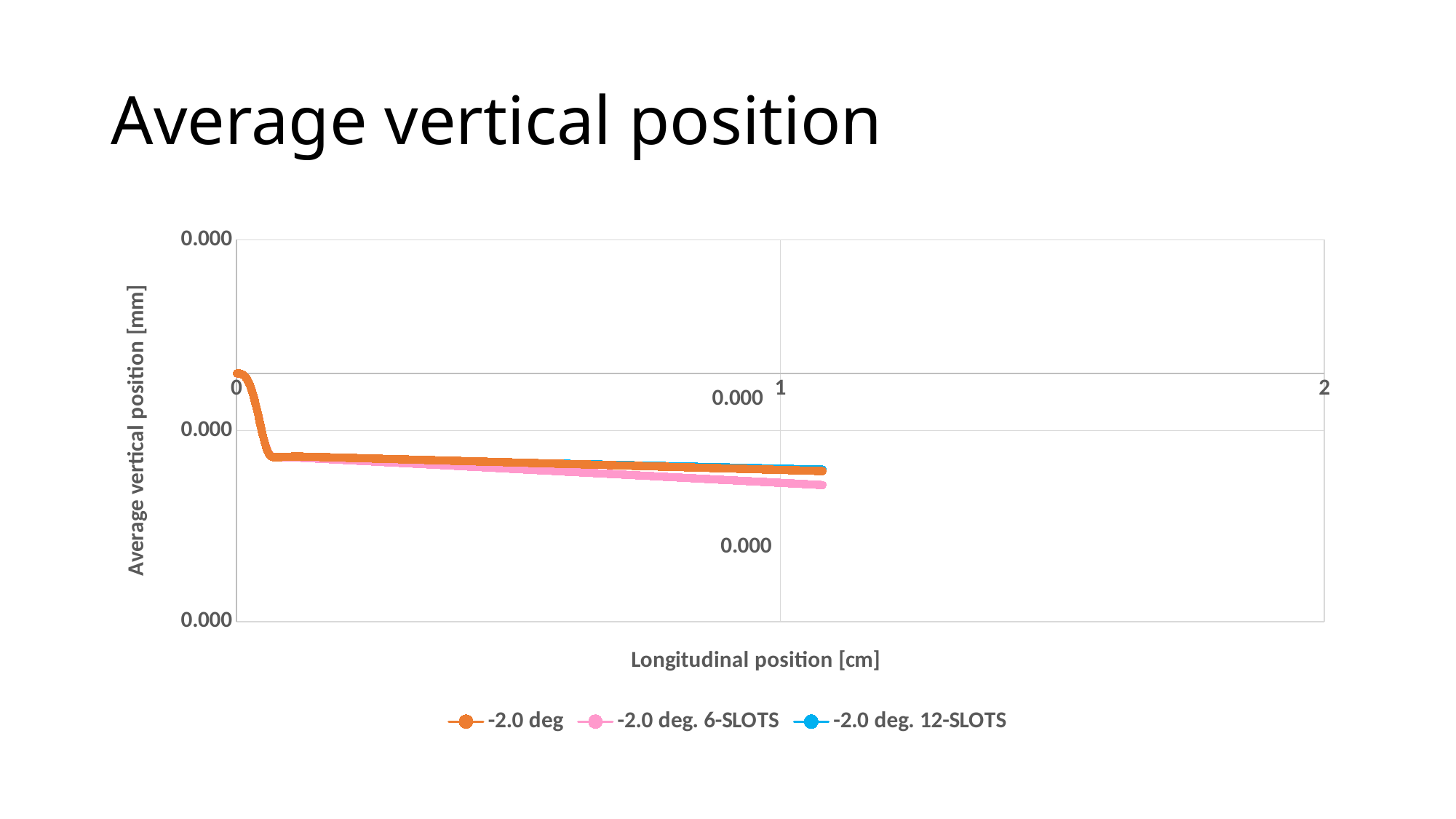
Does the -2.0 deg series rise or fall along the x axis overall? fall Do the plotted values rise or fall as the longitudinal position increases beyond the initial drop? fall How many series does the legend list? 3 What is the label of the x axis? Longitudinal position [cm] What kind of chart is shown on the slide? line chart Which series has the lowest average vertical position at the right end of the lines (near longitudinal position 1 cm)? -2.0 deg. 6-SLOTS At the right end of the lines, is the value for -2.0 deg larger or smaller than the value for -2.0 deg. 6-SLOTS? larger What is the title of the chart? Average vertical position